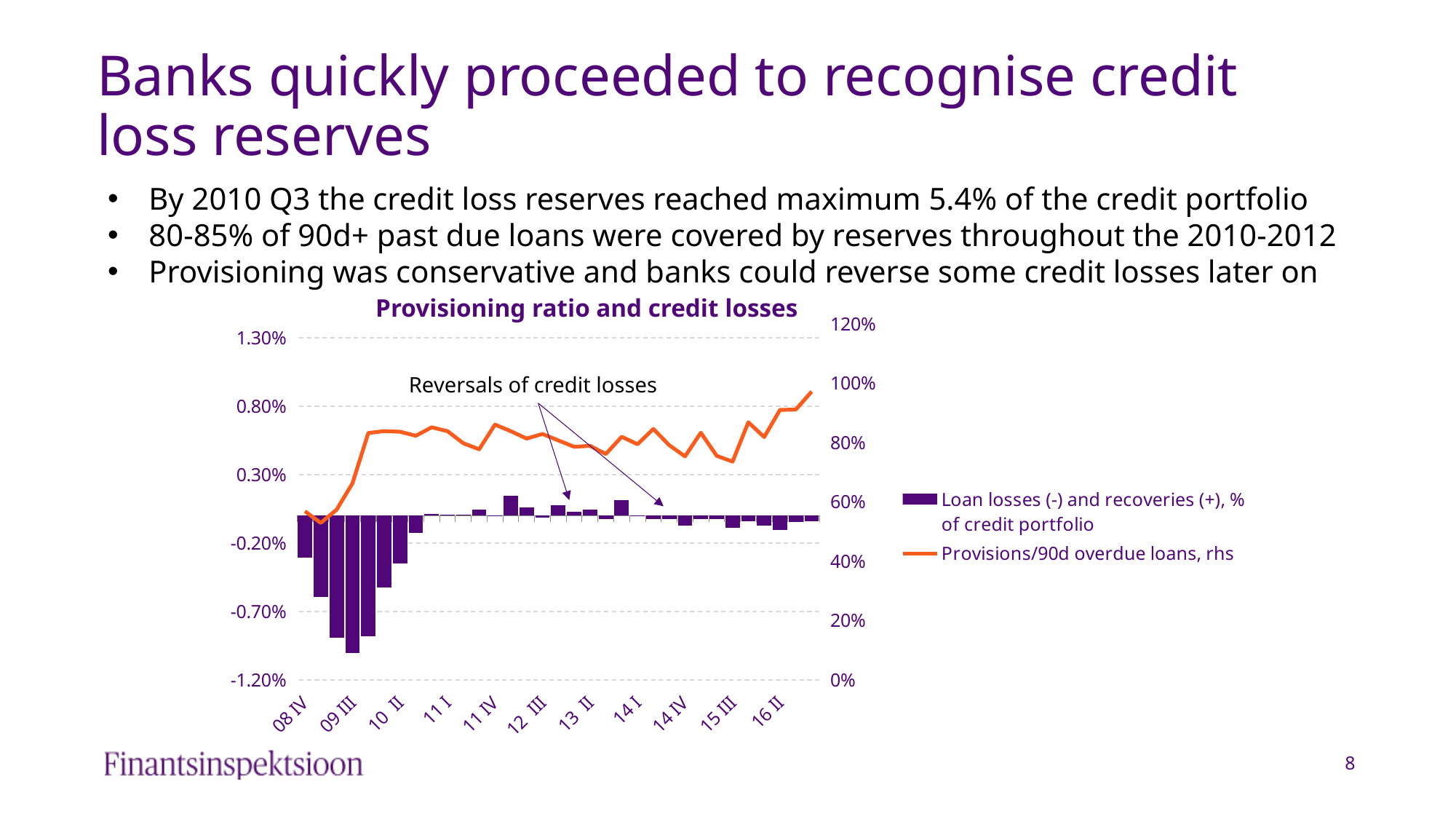
Is the Provisions/90d overdue loans value at 14 IV greater or less than 100%? less What is the title of the chart? Provisioning ratio and credit losses Is the loan losses bar for 09 III greater or less than -0.70%? less Does the Provisions/90d overdue loans line generally rise or fall from 08 IV to 16 II? rise How many series does the legend list? 2 Which labelled quarter has the lowest bar for loan losses? 09 III What is the highest value shown on the right-hand axis? 120% Is the loan losses bar for 08 IV greater or less than -0.20%? less Which series is plotted on the right-hand axis? Provisions/90d overdue loans, rhs How many quarter labels are shown on the x axis? 11 What type of chart is shown on the slide? Combination bar and line chart